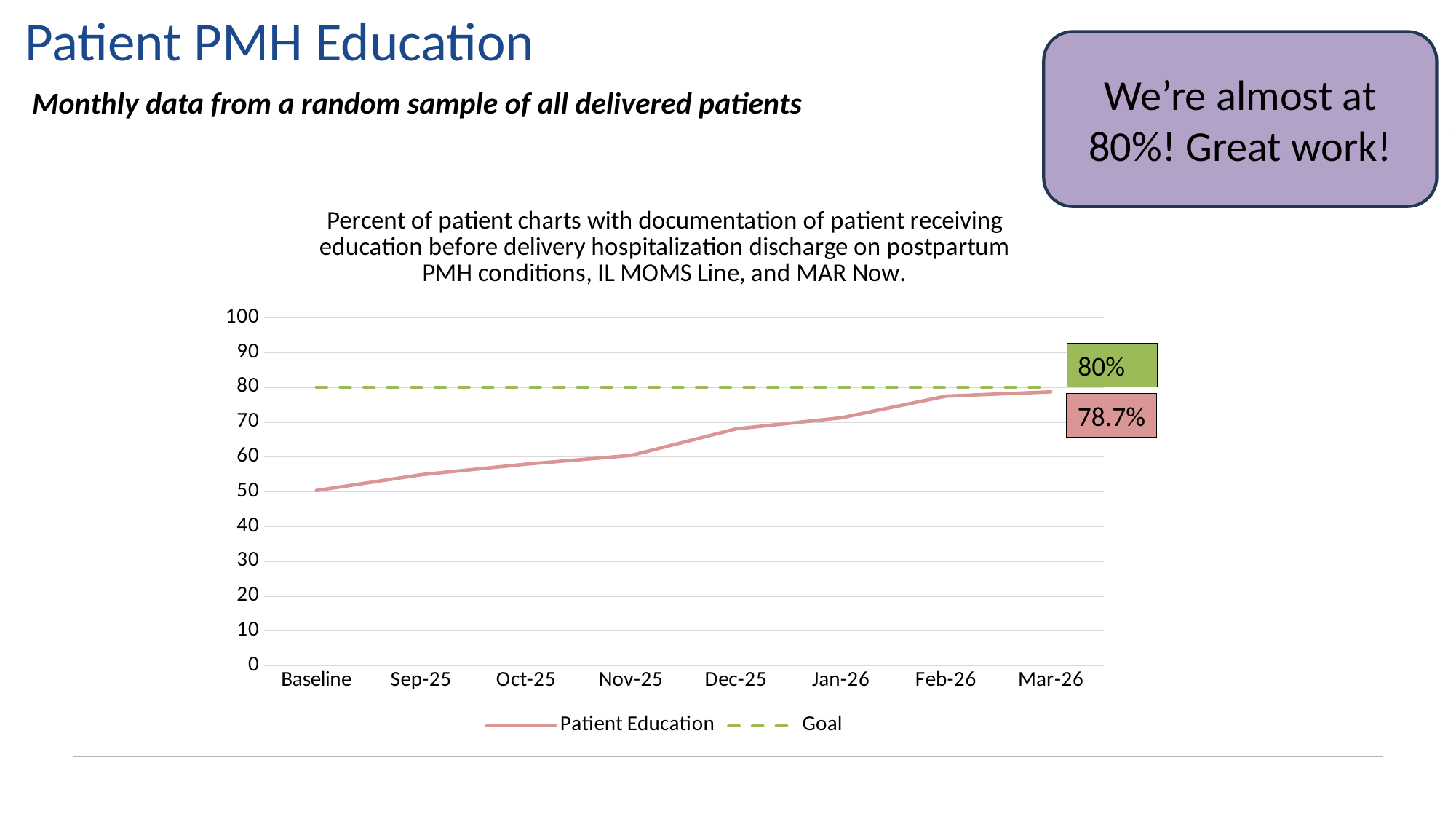
What kind of chart is shown on the slide? Line chart Which point on the x axis has the lowest Patient Education value? Baseline Does the Patient Education line rise or fall from Baseline to Mar-26? Rises Which point on the x axis has the highest Patient Education value? Mar-26 How many points are plotted along the x axis of the chart? 8 Is the Patient Education value for Baseline greater or less than 60? less Which is larger, the Patient Education value for Mar-26 or the Goal value? Goal What is the difference between the Goal and the Mar-26 Patient Education value? 1.3 percentage points Is the Patient Education value for Dec-25 greater or less than 60? greater What is the Patient Education value for Mar-26? 78.7% What is the value of the Goal line? 80% How many series does the chart legend list? 2